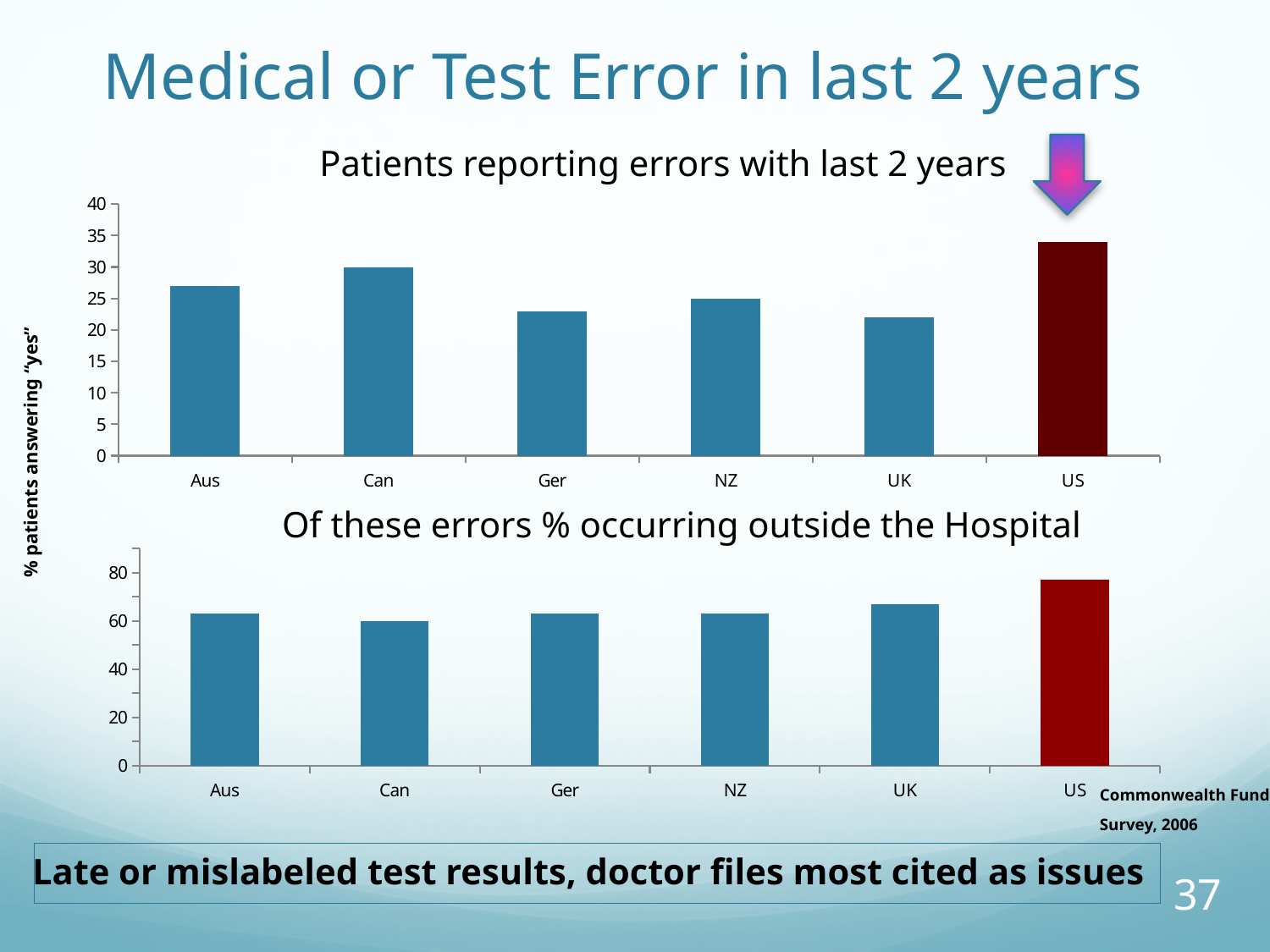
In the bottom chart 'Of these errors % occurring outside the Hospital', which country has the highest value? US In the bottom chart 'Of these errors % occurring outside the Hospital', is the value for Can greater or less than 80? less In the top chart 'Patients reporting errors with last 2 years', is the value for Aus greater or less than 25? greater In the top chart 'Patients reporting errors with last 2 years', which is larger, the value for Can or the value for Ger? Can In the top chart 'Patients reporting errors with last 2 years', is the value for UK greater or less than 25? less In the top chart, which country's bar is coloured dark red instead of blue? US In the bottom chart 'Of these errors % occurring outside the Hospital', which is larger, the value for UK or the value for Can? UK What kind of chart is the bottom chart 'Of these errors % occurring outside the Hospital'? Bar chart How many countries are shown in the top chart 'Patients reporting errors with last 2 years'? 6 In the top chart 'Patients reporting errors with last 2 years', which country has the highest value? US